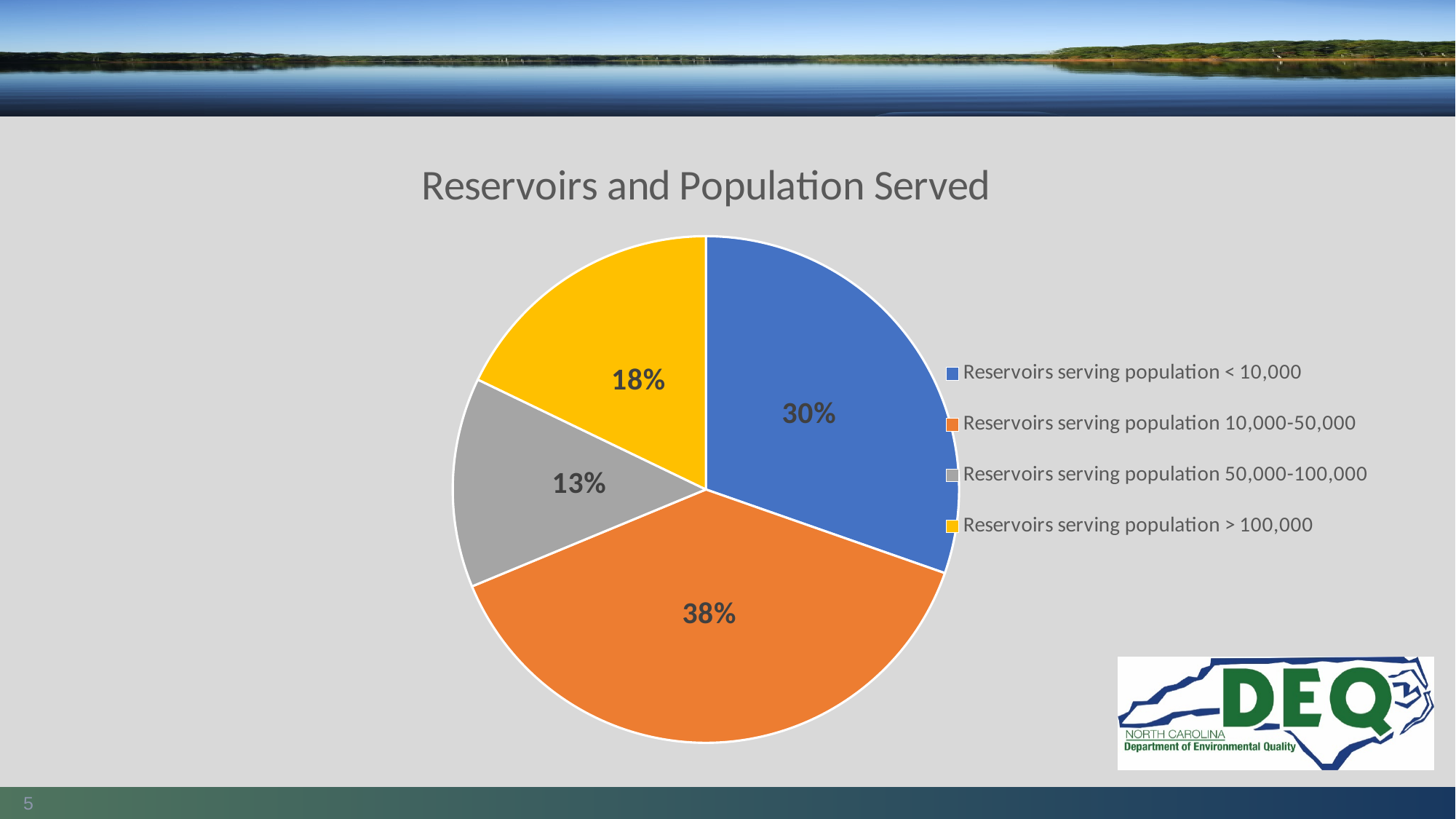
How many categories does the pie chart show? 4 What colour is the slice for 'Reservoirs serving population > 100,000'? Yellow What share of the pie is 'Reservoirs serving population 10,000-50,000'? 38% Which category has the largest slice of the pie? Reservoirs serving population 10,000-50,000 What share of the pie is 'Reservoirs serving population > 100,000'? 18% What share of the pie is 'Reservoirs serving population < 10,000'? 30% What kind of chart is shown on the slide? Pie chart Which is larger: the share for 'Reservoirs serving population > 100,000' or for 'Reservoirs serving population 50,000-100,000'? Reservoirs serving population > 100,000 Which category has the smallest slice of the pie? Reservoirs serving population 50,000-100,000 What is the difference in percentage points between 'Reservoirs serving population 10,000-50,000' and 'Reservoirs serving population < 10,000'? 8% What is the title of the chart? Reservoirs and Population Served